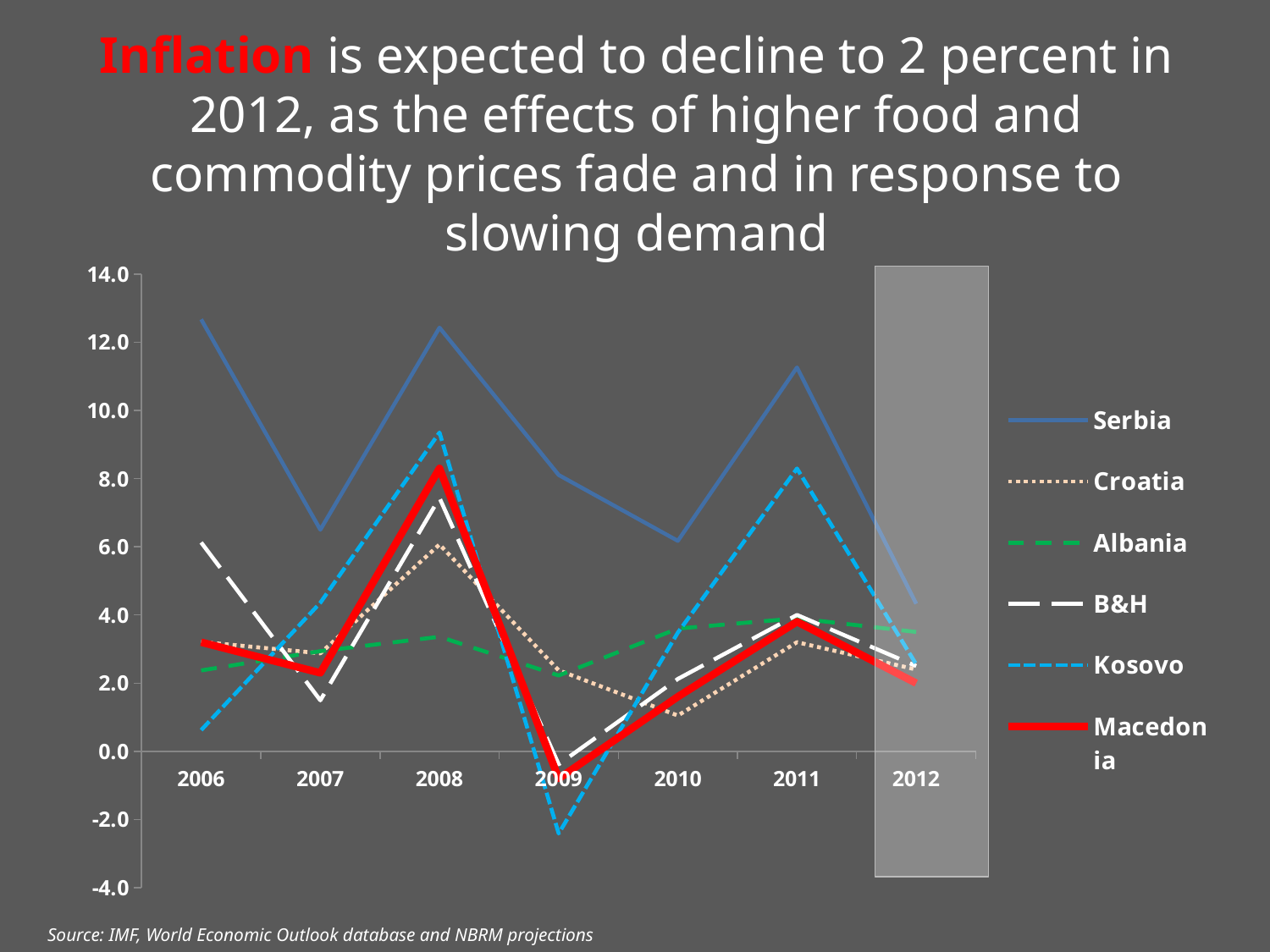
Is the value for Albania in 2006 greater or less than 4.0? less What kind of chart is shown on the slide? line chart Which is larger in 2010, the value for Serbia or the value for Albania? Serbia Is the value for Kosovo in 2009 greater or less than 0.0? less Which series has the lowest value in 2009? Kosovo How many series does the legend list? 6 Does the Serbia line rise or fall from 2011 to 2012? fall How many years are shown on the x axis? 7 Which series has the highest value in 2006? Serbia Which series has the highest value in 2011? Serbia Which series is drawn as a thick solid red line? Macedonia Is the value for Serbia in 2008 greater or less than 10.0? greater